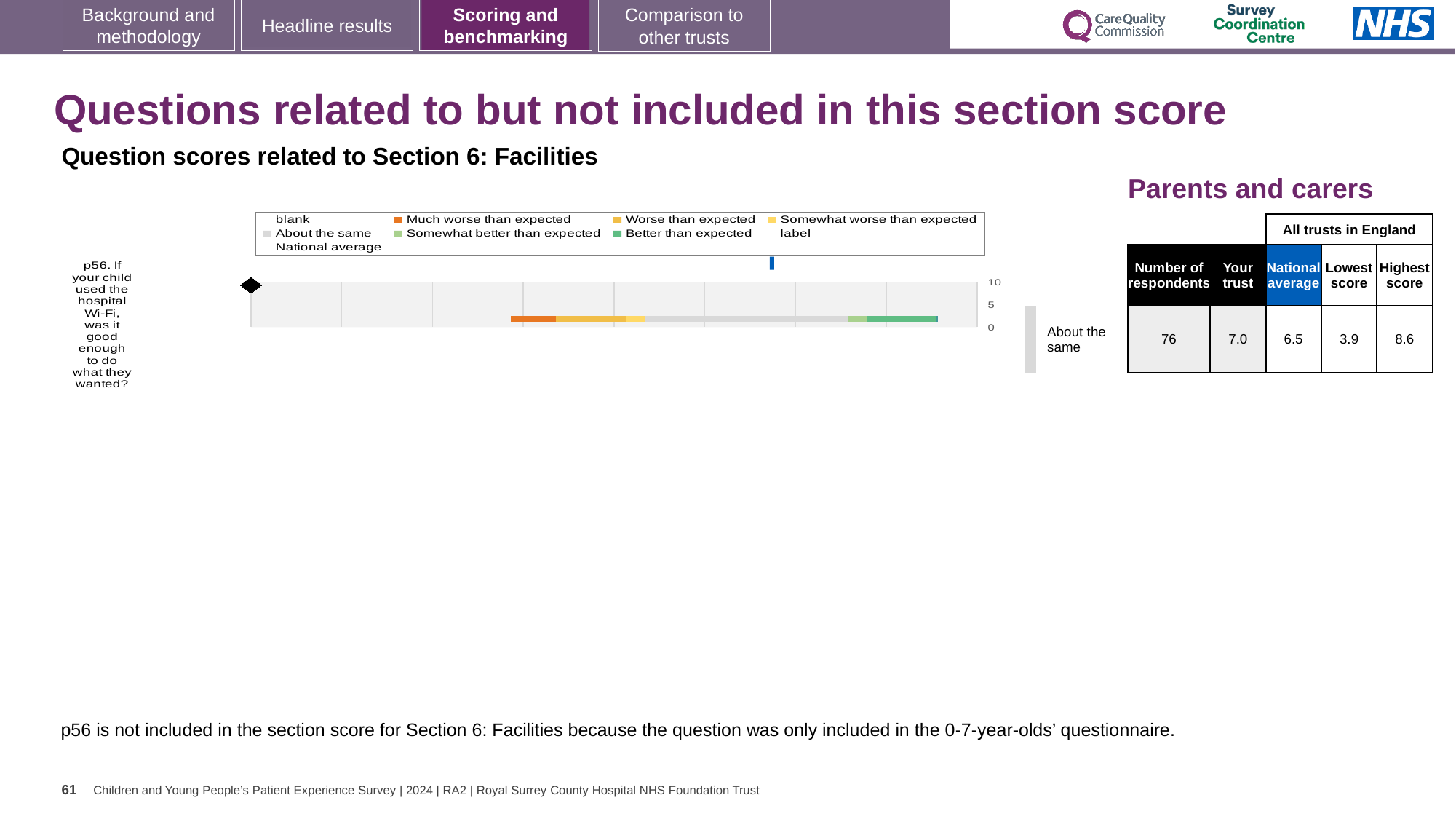
In the table, what is the lowest score among all trusts in England for p56? 3.9 In the table, what is the national average score for p56? 6.5 What is the difference between the highest score and the lowest score for p56 in the table? 4.7 In the table, what is the highest score among all trusts in England for p56? 8.6 Is the 'Your trust' score for p56 higher or lower than the national average? Higher In the table, what is the 'Your trust' score for p56? 7.0 What is the highest value shown on the chart's axis? 10 What kind of chart is shown on the slide? Bar chart Which question is plotted in the chart? p56. If your child used the hospital Wi-Fi, was it good enough to do what they wanted? In the table, how many respondents are listed for p56? 76 What benchmark label is shown to the right of the chart for p56? About the same How many questions (categories) are plotted in the chart? 1